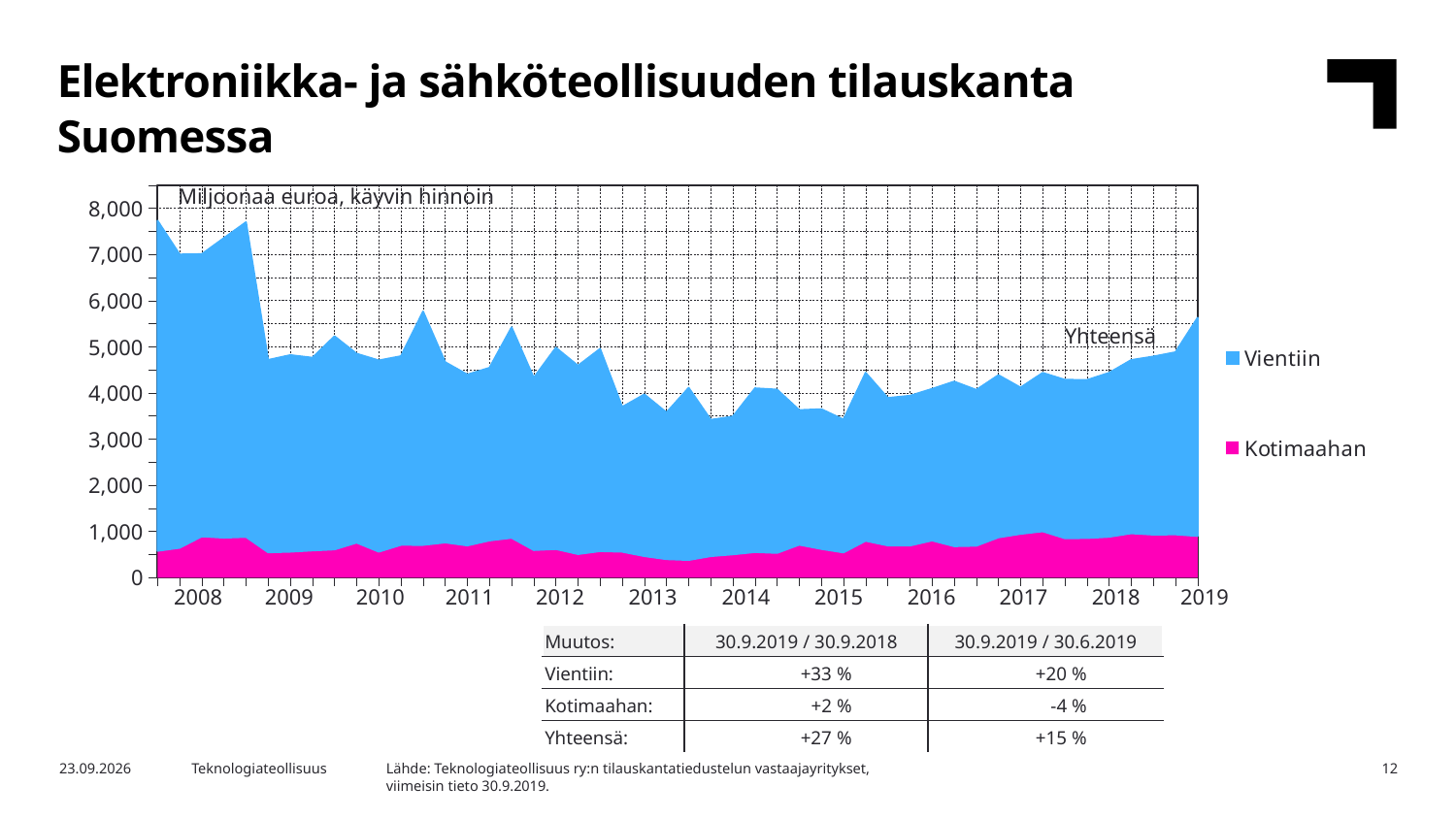
How many year labels are shown on the x axis of the chart? 12 Does the total order book rise or fall between 2017 and 2019? Rise What kind of chart is shown on the slide? Area chart Which series is larger throughout the chart, Vientiin or Kotimaahan? Vientiin Does the total order book rise or fall between 2008 and 2009? Fall Is the total (Yhteensä) order book at the start of 2008 greater or less than 7,000? greater How many series does the chart legend list? 2 Is the total (Yhteensä) order book at the 2019 end of the chart greater or less than 5,000? greater What are the two series named in the chart legend? Vientiin and Kotimaahan What unit is stated at the top of the chart? Miljoonaa euroa, käyvin hinnoin Is the Kotimaahan value at the start of 2014 greater or less than 1,000? less In the table below the chart, what is the change for Vientiin for 30.9.2019 / 30.9.2018? +33 %